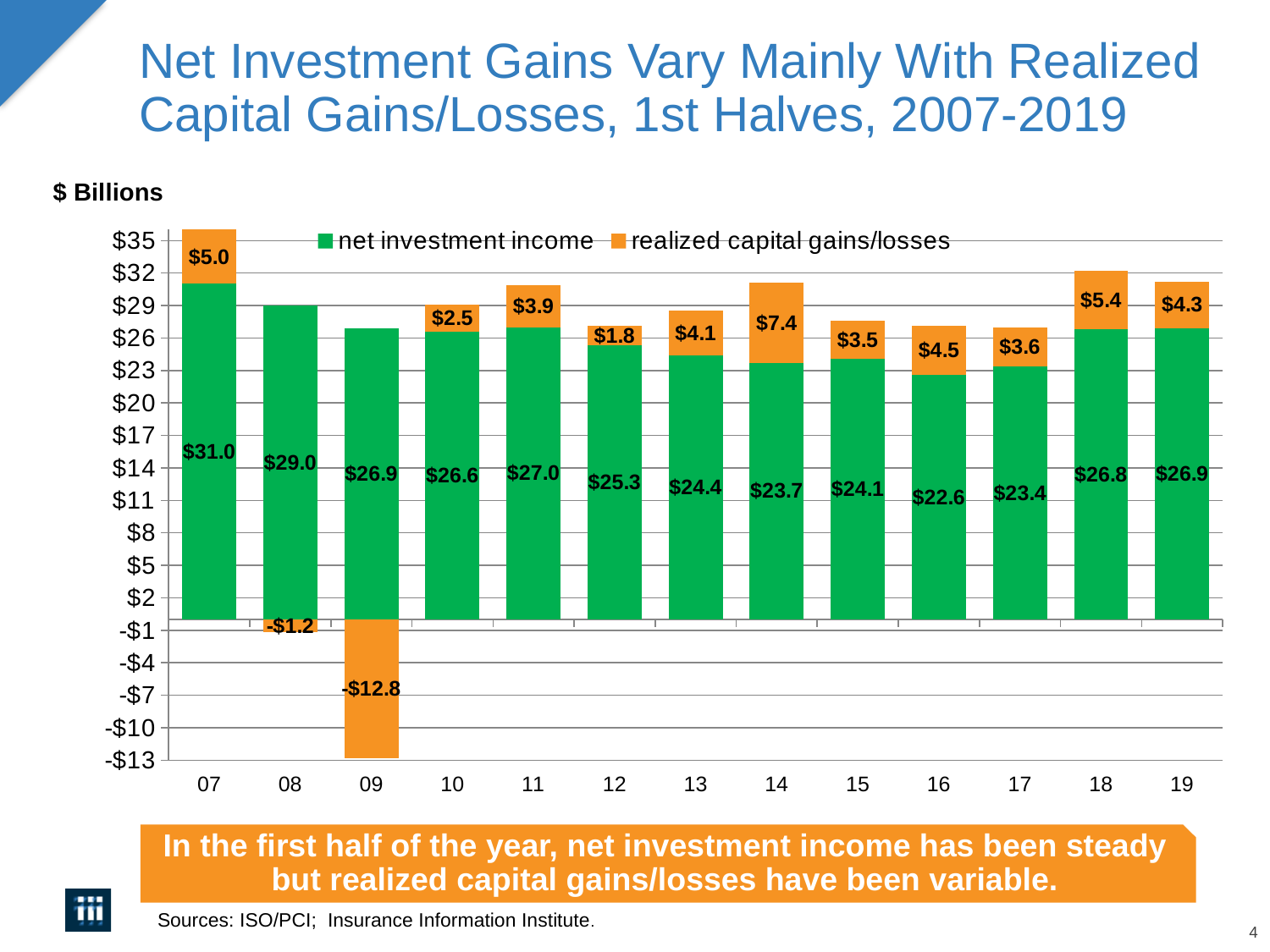
What is the net investment income for 16? $22.6 How many series does the legend list? 2 What is the difference between net investment income in 07 and in 08? $2.0 What kind of chart is shown on the slide? Stacked bar chart What is the total of the stacked bar for 18 (net investment income plus realized capital gains/losses)? $32.2 Which year has the highest net investment income? 07 How many years are shown on the x axis? 13 Which is larger, the realized capital gains/losses value for 18 or for 19? 18 What is the realized capital gains/losses value for 09? -$12.8 What is the realized capital gains/losses value for 14? $7.4 What is the net investment income for 07? $31.0 Which year has the lowest realized capital gains/losses value? 09